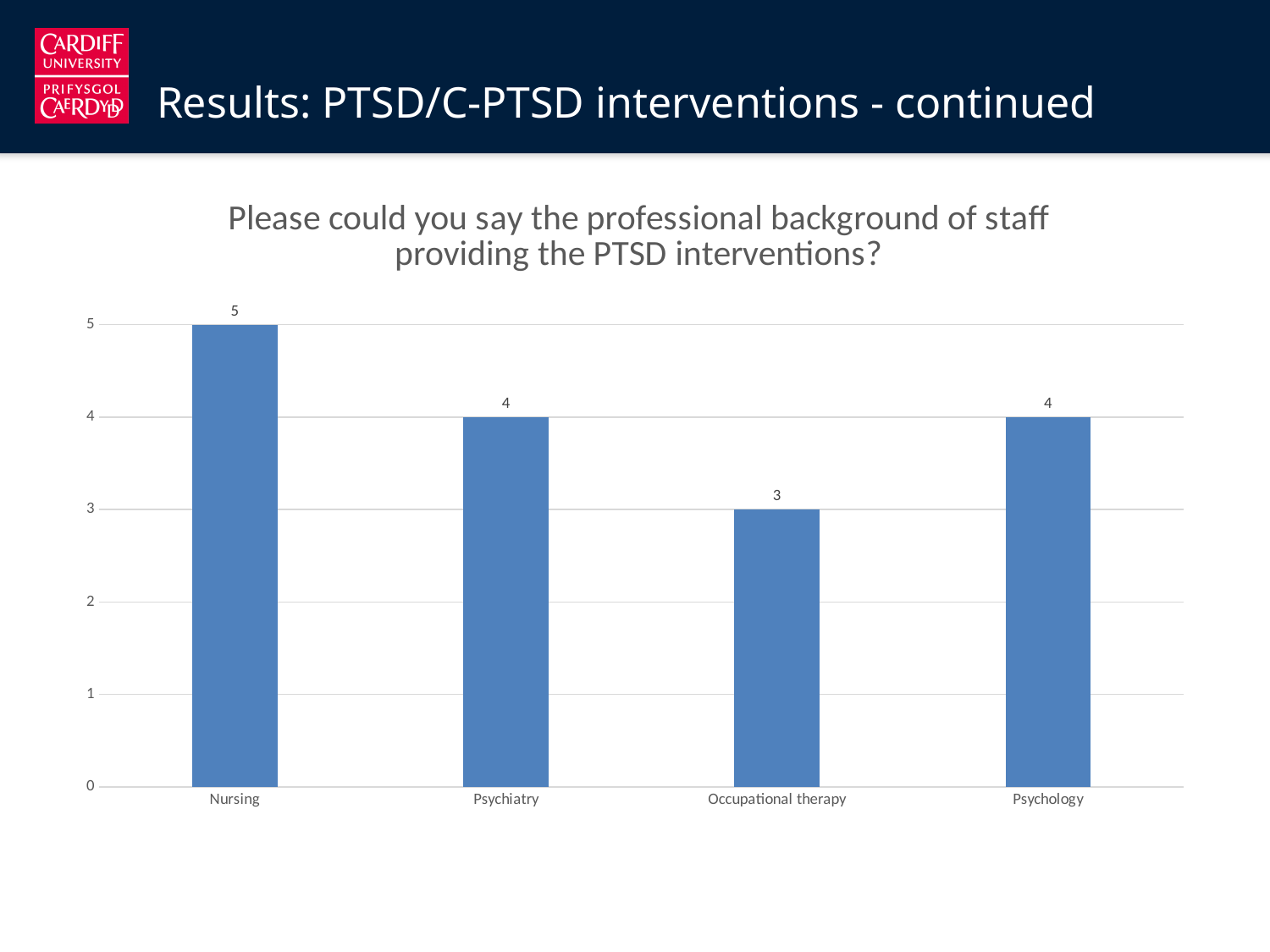
What is the title of the chart? Please could you say the professional background of staff providing the PTSD interventions? Which is larger, the value for Psychiatry or the value for Occupational therapy? Psychiatry Which category has the highest value? Nursing What is the difference between the values for Nursing and Occupational therapy? 2 What is the value for Psychology? 4 Is the value for Nursing greater or less than 4? greater Which category has the lowest value? Occupational therapy What is the value for Occupational therapy? 3 What kind of chart is shown on the slide? bar chart What is the difference between the values for Psychiatry and Psychology? 0 How many categories are shown on the x axis? 4 What is the value for Nursing? 5